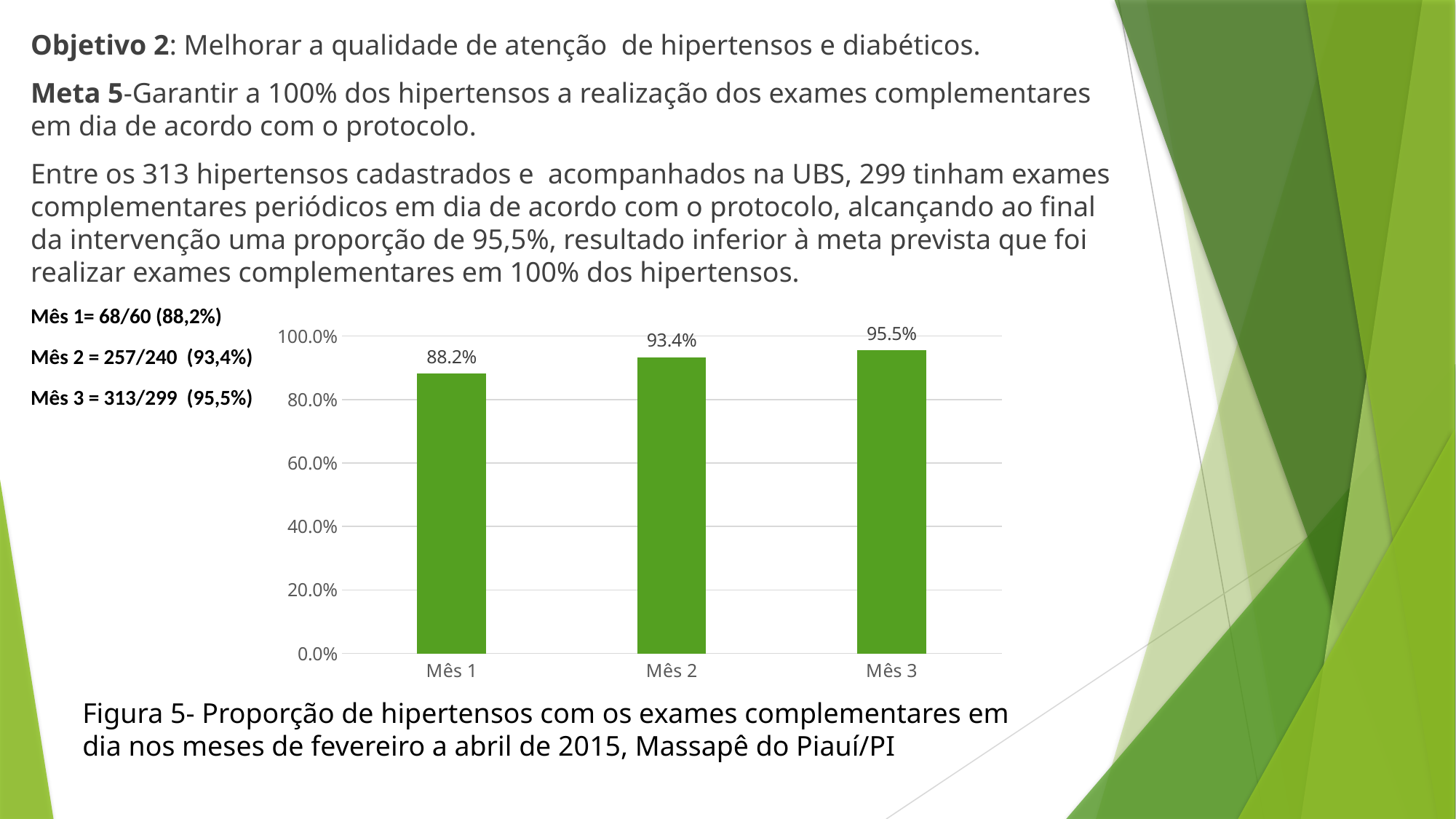
What kind of chart is shown on the slide? Bar chart Which is larger, the value for Mês 1 or the value for Mês 2? Mês 2 What is the difference between the values for Mês 2 and Mês 1? 5.2% Which month has the highest value? Mês 3 What is the value for Mês 1? 88.2% What is the difference between the values for Mês 3 and Mês 1? 7.3% Do the values rise or fall from Mês 1 to Mês 3? Rise Which month has the lowest value? Mês 1 What is the value for Mês 3? 95.5% Is the value for Mês 1 greater or less than 80.0%? greater What is the value for Mês 2? 93.4% How many months are shown on the x axis? 3